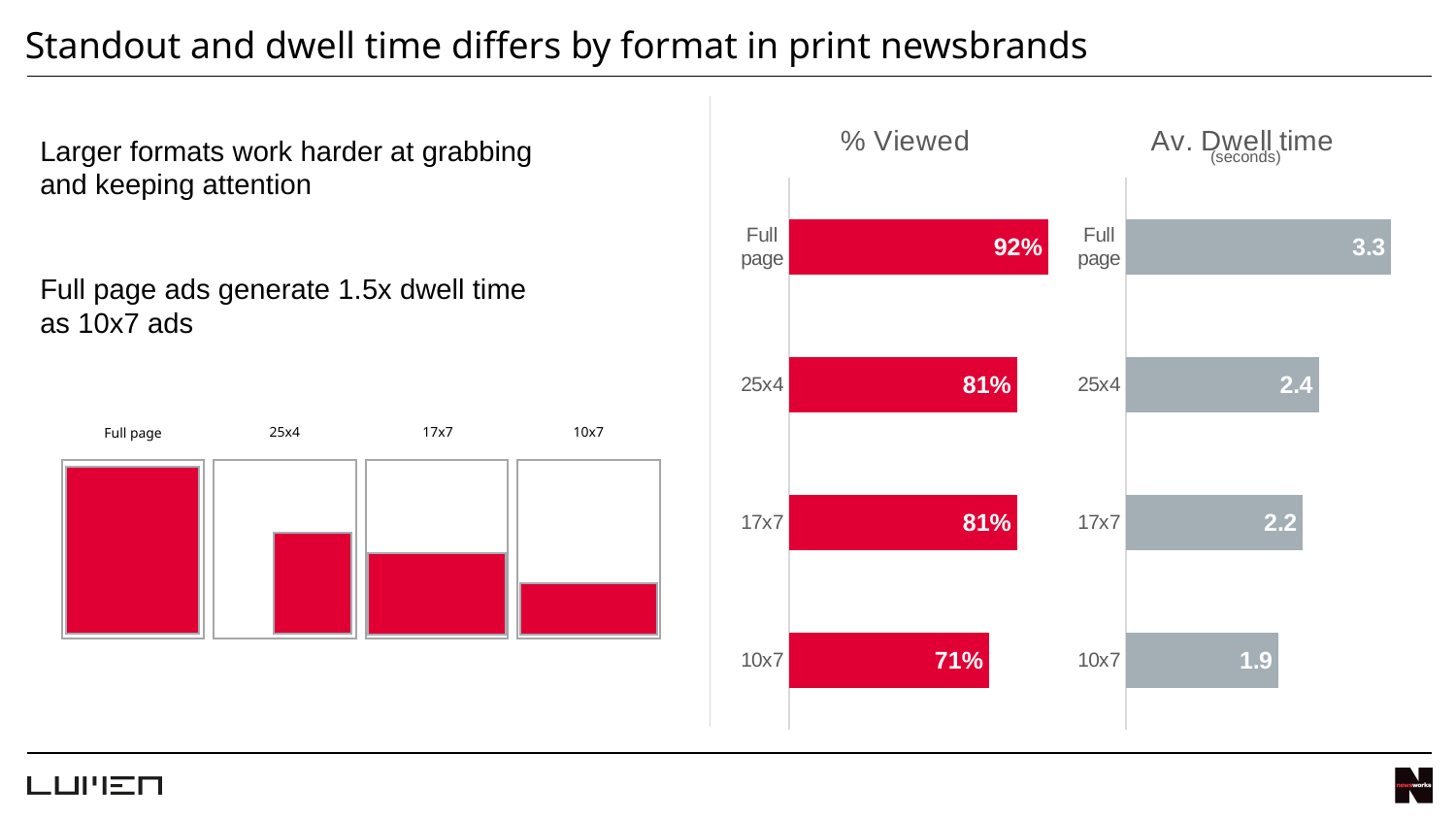
In the 'Av. Dwell time' chart, what is the value for 10x7? 1.9 In the '% Viewed' chart, what is the difference between Full page and 10x7? 21% How many formats are shown in the '% Viewed' chart? 4 In the 'Av. Dwell time' chart, which format has the highest value? Full page In the '% Viewed' chart, which format has the lowest value? 10x7 In the 'Av. Dwell time' chart, which is larger, 25x4 or 17x7? 25x4 In the '% Viewed' chart, do the values rise or fall from Full page down to 10x7? Fall In the 'Av. Dwell time' chart, what is the value for 25x4? 2.4 In the '% Viewed' chart, what is the value for Full page? 92% What kind of chart is the 'Av. Dwell time' chart? Bar chart In the 'Av. Dwell time' chart, what is the difference between Full page and 10x7? 1.4 What unit is given under the title of the 'Av. Dwell time' chart? seconds